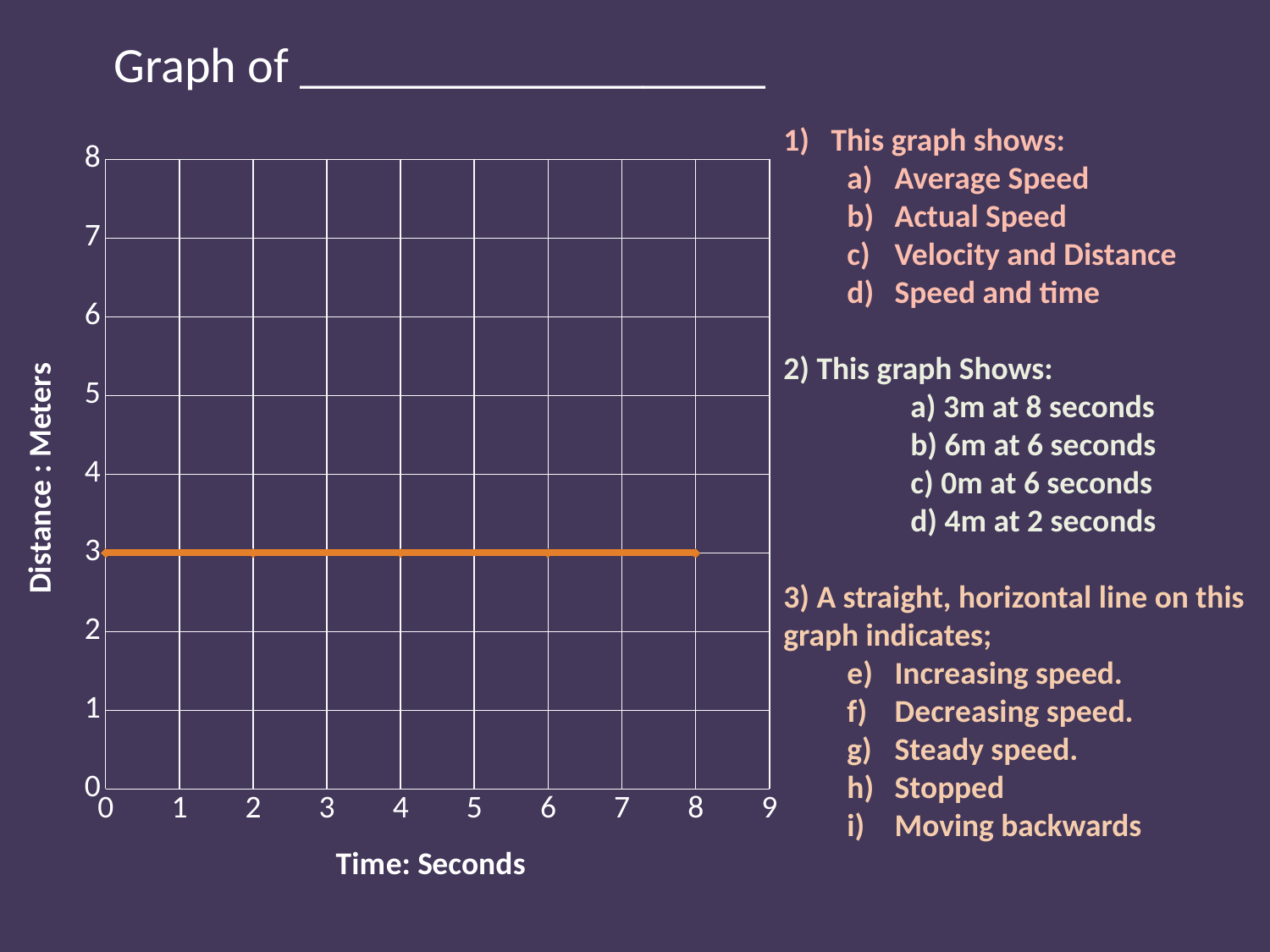
At what time in seconds does the plotted line end? 8 Is the distance at 2 seconds greater or less than 2 meters? greater What is the highest value shown on the y axis? 8 Does the distance rise, fall, or stay constant as time increases from 0 to 8 seconds? stays constant What is the difference between the distance at 8 seconds and the distance at 0 seconds? 0 What is the label of the y axis? Distance : Meters Is the distance at 6 seconds greater or less than 5 meters? less What kind of chart is shown on the slide? line chart What is the distance in meters at 4 seconds? 3 What is the distance in meters at 8 seconds? 3 What is the label of the x axis? Time: Seconds What is the distance in meters at 0 seconds? 3